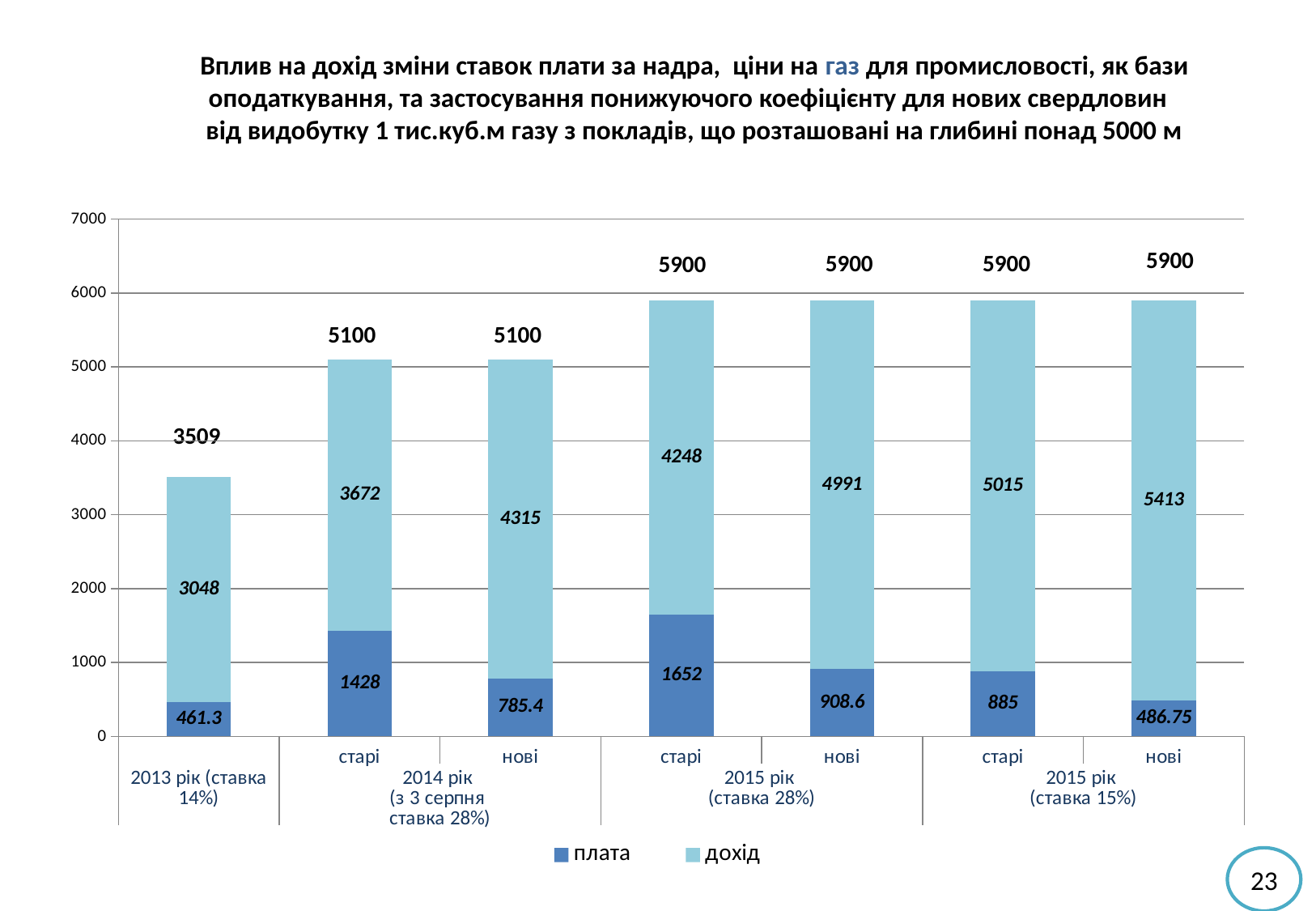
What is the total printed above the 2013 рік (ставка 14%) bar? 3509 Which legend entry is shown in dark blue? плата How many series does the legend list? 2 What is the value of плата for the старі bar in 2015 рік (ставка 28%)? 1652 What is the value of дохід for the нові bar in 2015 рік (ставка 15%)? 5413 Which bar has the highest плата value? старі, 2015 рік (ставка 28%) Which is larger: the дохід value for старі in 2015 рік (ставка 28%) or for старі in 2015 рік (ставка 15%)? старі in 2015 рік (ставка 15%) What is the value of плата for the 2013 рік (ставка 14%) bar? 461.3 What type of chart is shown on the slide? stacked bar chart How many bars are plotted in the chart? 7 Which bar has the lowest дохід value? 2013 рік (ставка 14%) What is the difference between the плата values of старі and нові in 2014 рік (з 3 серпня ставка 28%)? 642.6